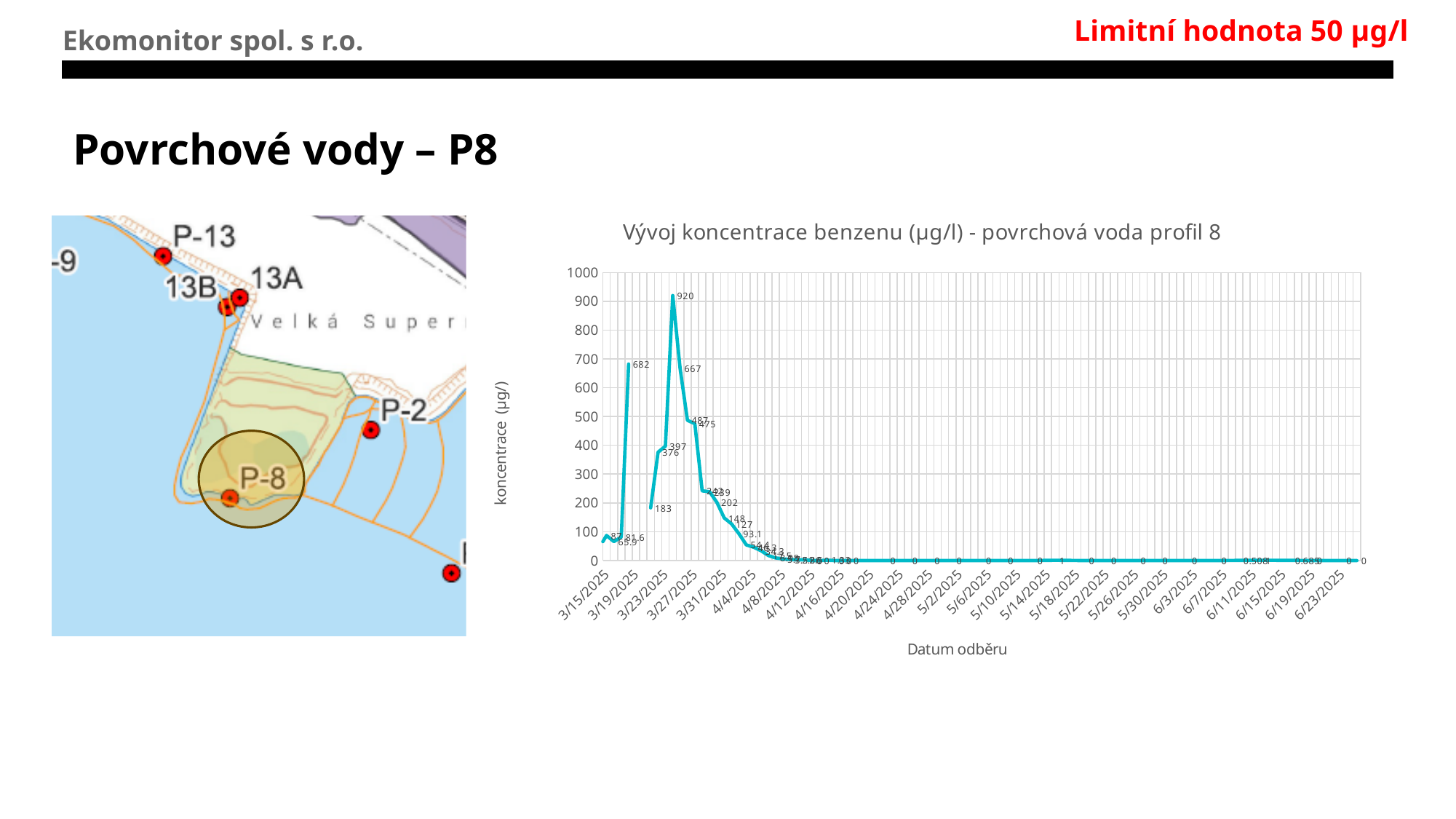
Which labeled value is larger, 682 or 667? 682 After the peak, do the concentration values rise or fall toward the end of the x axis? fall Is the peak value on the chart greater or less than 900? greater What is the difference between the peak value 920 and the following labeled value 667? 253 What is the difference between the labeled values 682 and 183? 499 What is the lowest value labeled on the chart? 0 What kind of chart is shown on the slide? line chart What is the highest benzene concentration value labeled on the chart? 920 What is the label of the x axis of the chart? Datum odběru What is the title of the chart? Vývoj koncentrace benzenu (µg/l) - povrchová voda profil 8 How many date labels are shown on the x axis? 26 What is the highest tick value shown on the y axis? 1000